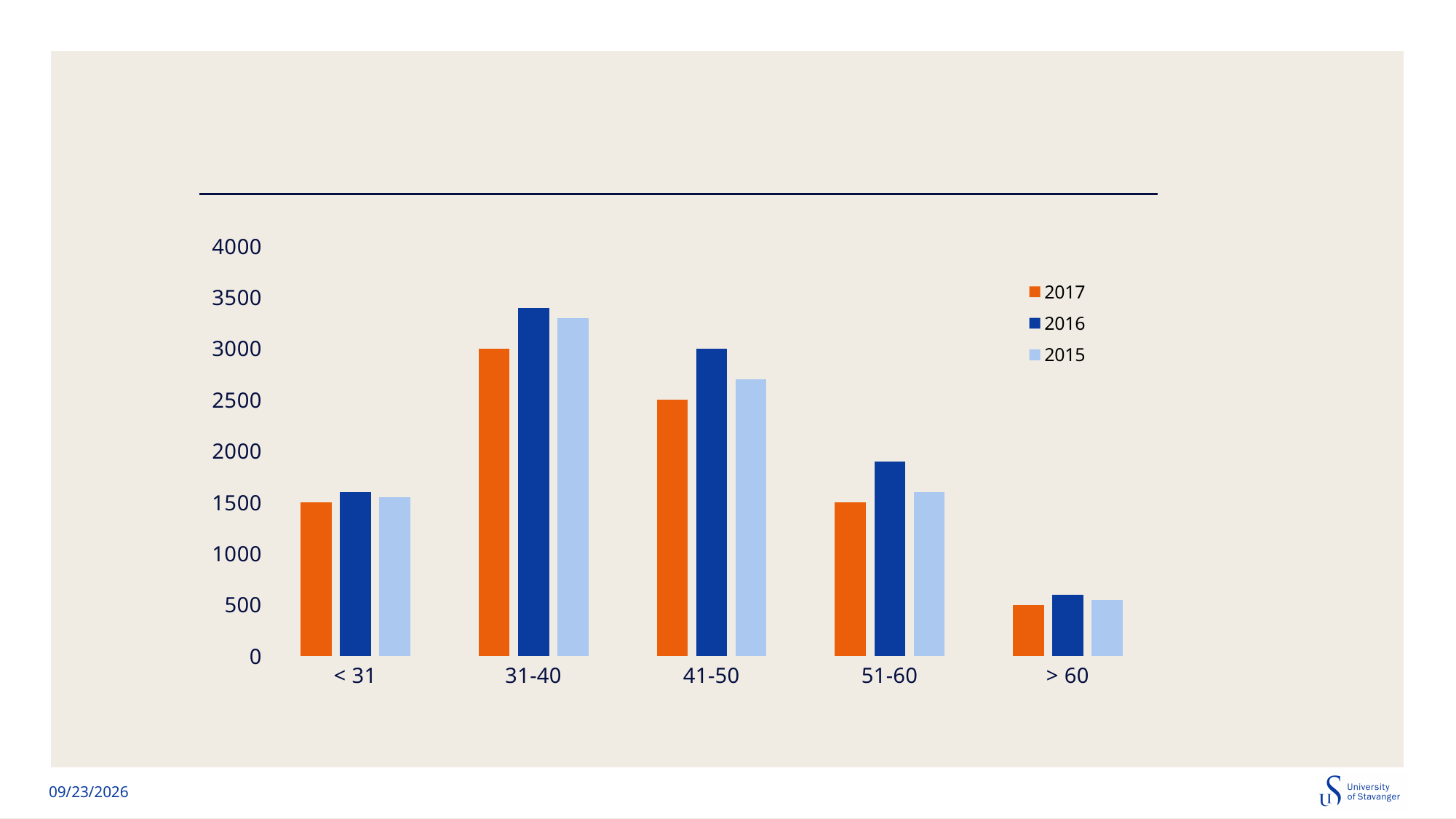
In the 51-60 category, which is larger: the 2016 value or the 2017 value? 2016 Which series is listed first in the legend? 2017 How many series does the legend list? 3 Is the 2015 value for the > 60 category greater or less than 1000? less Which age category has the lowest values across all three series? > 60 Is the 2015 value for the 41-50 category greater or less than 2500? greater How many age categories are shown on the x axis? 5 Which colour represents the 2017 series in the legend? orange Which age category has the highest value for the 2016 series? 31-40 What kind of chart is shown on the slide? bar chart Is the 2016 value for the 31-40 category greater or less than 3000? greater